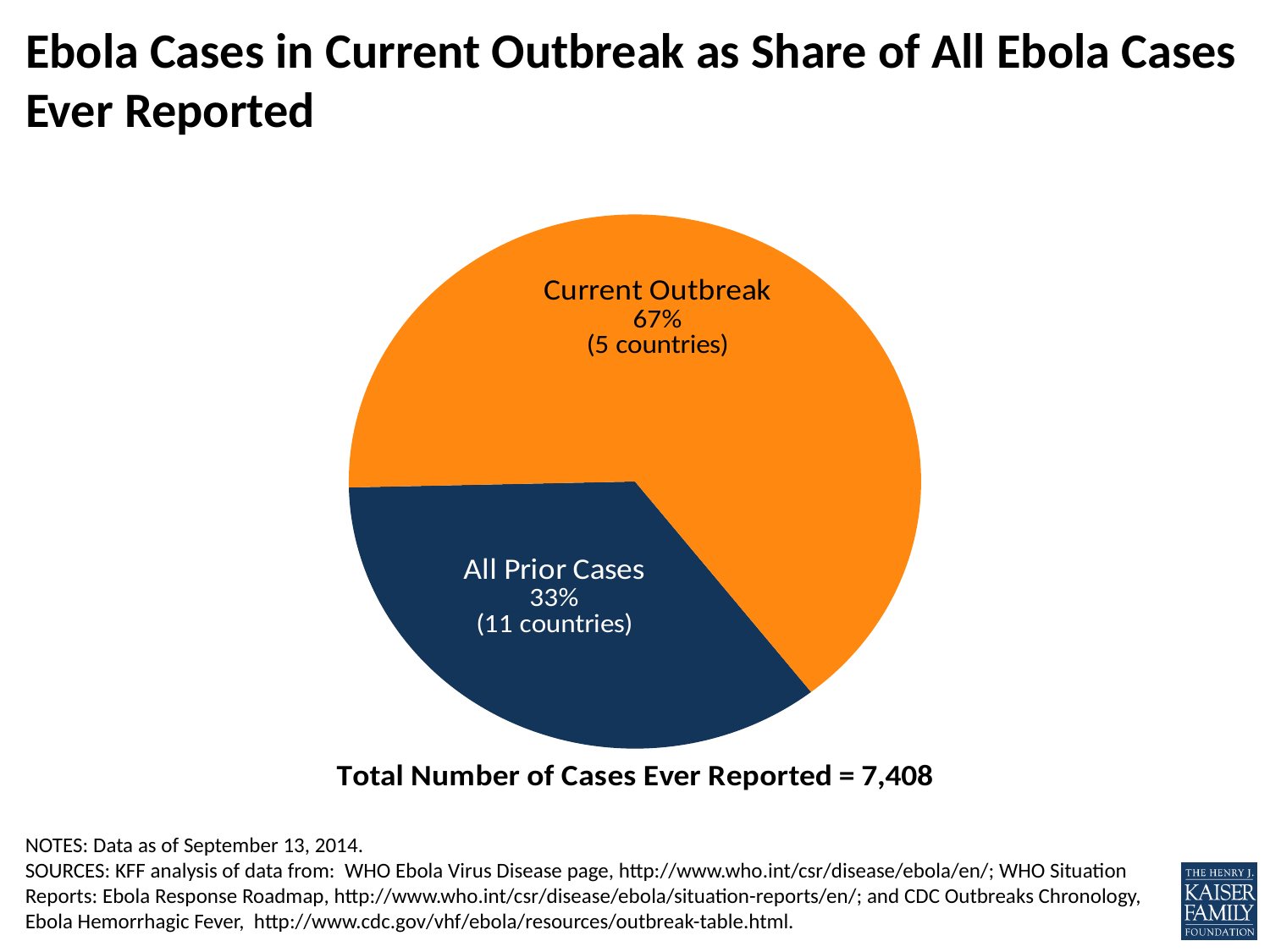
How many countries are associated with the All Prior Cases slice? 11 countries What is the total number of Ebola cases ever reported, as stated below the chart? 7,408 Which slice of the pie is the smallest? All Prior Cases What share of the pie is All Prior Cases? 33% How many countries are associated with the Current Outbreak slice? 5 countries Which slice of the pie is the largest? Current Outbreak What share of all Ebola cases ever reported does the Current Outbreak slice represent? 67% How many slices does the pie chart have? 2 What is the difference in percentage points between the Current Outbreak share and the All Prior Cases share? 34 percentage points What kind of chart is shown on the slide? pie chart What colour is the Current Outbreak slice? orange Which is larger, the Current Outbreak share or the All Prior Cases share? Current Outbreak